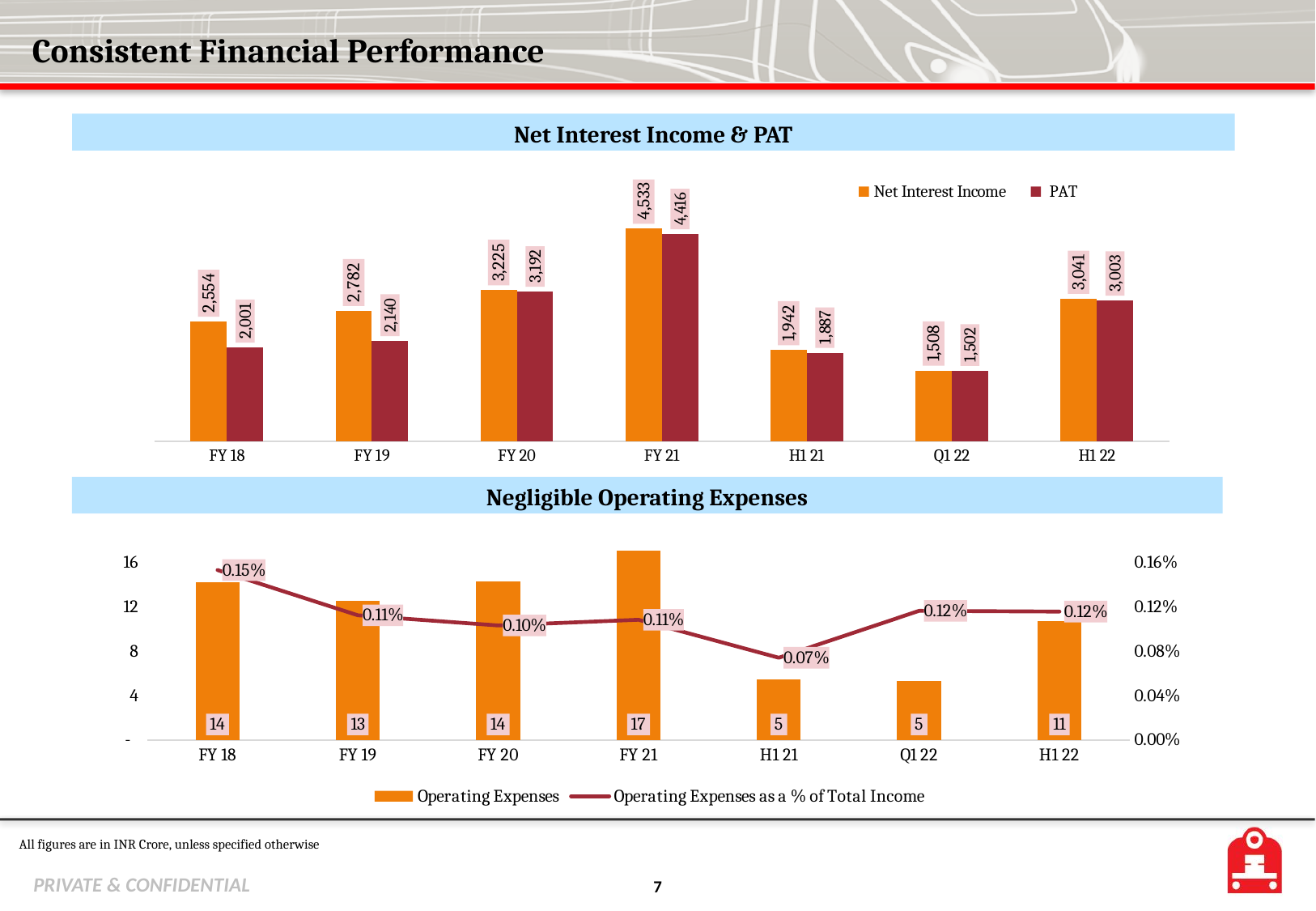
In the 'Net Interest Income & PAT' chart, which period has the highest Net Interest Income? FY 21 In the 'Net Interest Income & PAT' chart, how many series does the legend list? 2 In the 'Net Interest Income & PAT' chart, what is the difference between Net Interest Income and PAT for FY 18? 553 In the 'Net Interest Income & PAT' chart, which period has the lowest PAT? Q1 22 In the 'Net Interest Income & PAT' chart, what is the Net Interest Income for FY 21? 4,533 What kind of chart is the 'Net Interest Income & PAT' chart? Bar chart In the 'Negligible Operating Expenses' chart, which period has the highest Operating Expenses as a % of Total Income? FY 18 In the 'Negligible Operating Expenses' chart, what is the Operating Expenses value for FY 21? 17 In the 'Negligible Operating Expenses' chart, what is Operating Expenses as a % of Total Income for H1 21? 0.07% In the 'Net Interest Income & PAT' chart, how many periods are shown on the x axis? 7 In the 'Negligible Operating Expenses' chart, is the Operating Expenses value for FY 19 larger than for H1 22? Yes In the 'Net Interest Income & PAT' chart, what is the PAT for H1 22? 3,003